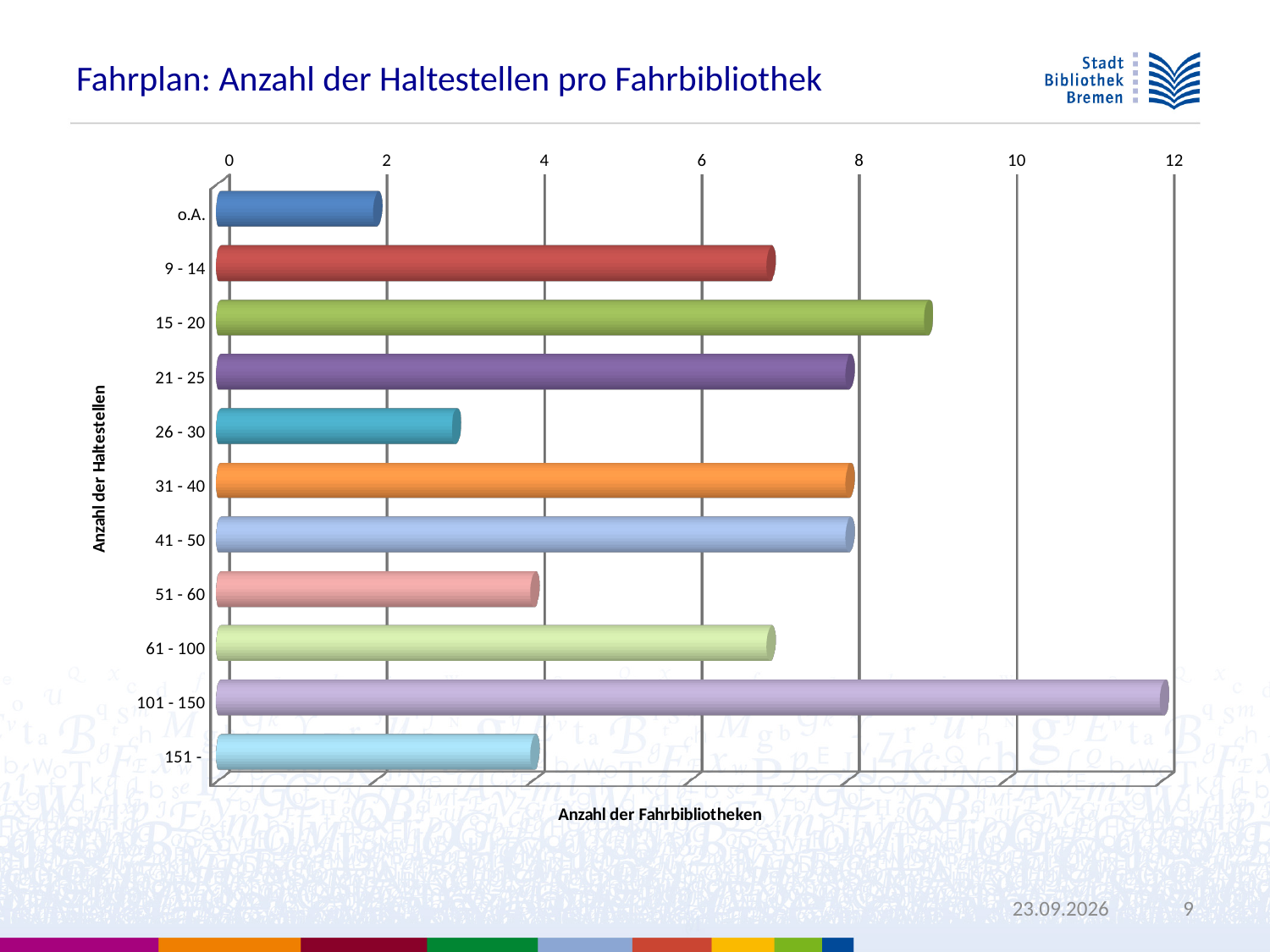
Which has more Fahrbibliotheken, 15 - 20 or 9 - 14? 15 - 20 Which category has the lowest number of Fahrbibliotheken? o.A. Is the value for 15 - 20 greater or less than 8? greater Is the value for o.A. greater or less than 4? less Is the value for 9 - 14 greater or less than 6? greater Which has more Fahrbibliotheken, 26 - 30 or 51 - 60? 51 - 60 Which category has the highest number of Fahrbibliotheken? 101 - 150 What kind of chart is shown on the slide? bar chart What is the label of the horizontal axis? Anzahl der Fahrbibliotheken How many categories (Haltestellen ranges) are shown on the chart? 11